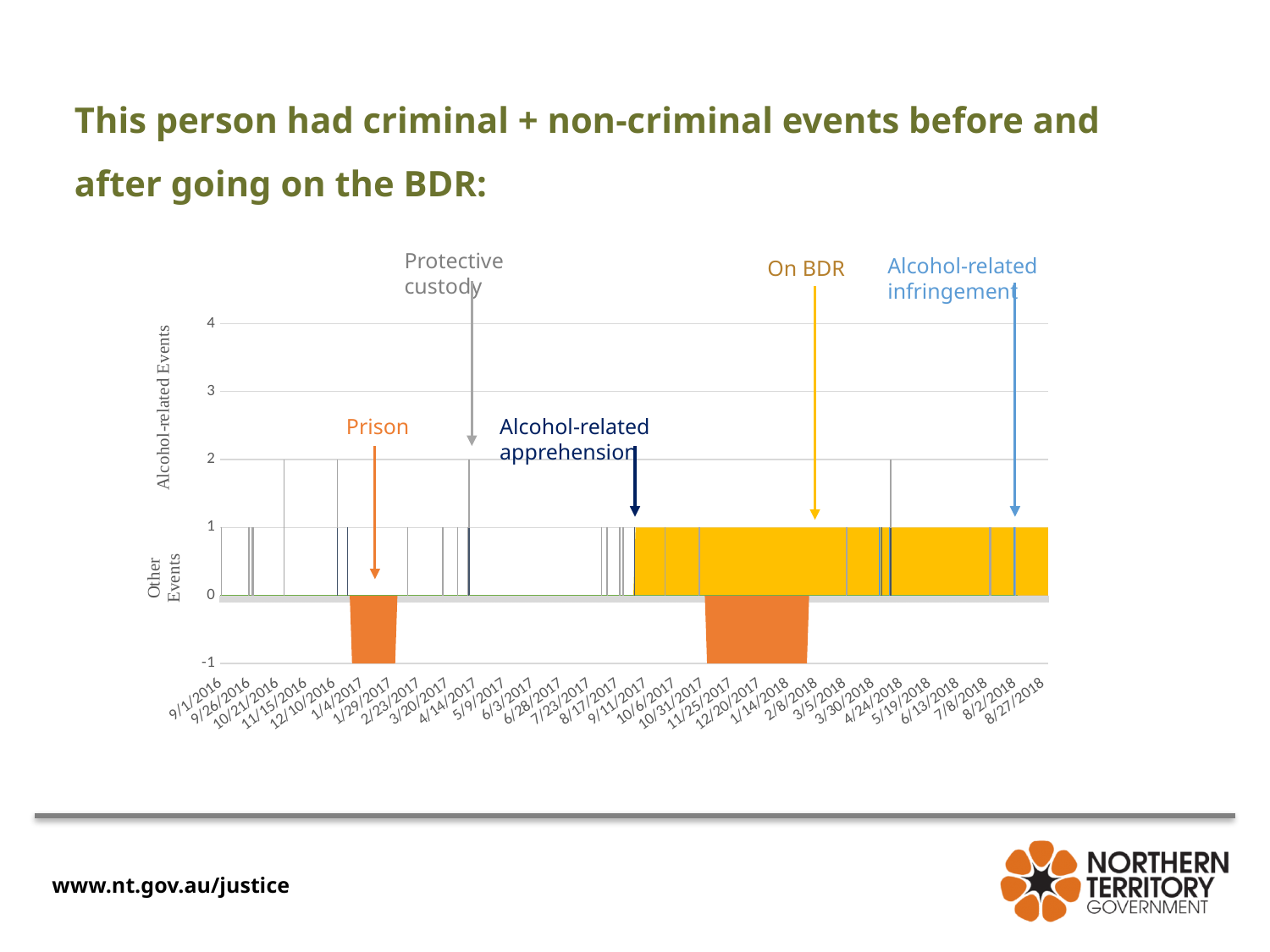
Does the 'On BDR' period begin before or after the second prison period? before Which prison period is longer, the first one (early 2017) or the second one (late 2017 to early 2018)? the second one What label is given to the upper part of the y axis? Alcohol-related Events What is the last date shown on the x axis? 8/27/2018 Which event type is shown in yellow on the chart? On BDR At what value on the y axis do the prison bars extend down to? -1 How many different event types are labelled with arrows on the chart? 5 What kind of chart is shown on the slide? area chart How many separate prison periods are shown on the chart? 2 What is the first date shown on the x axis? 9/1/2016 Is the height of the tallest alcohol-related event bar greater or less than 3? less What is the highest value shown on the y axis? 4